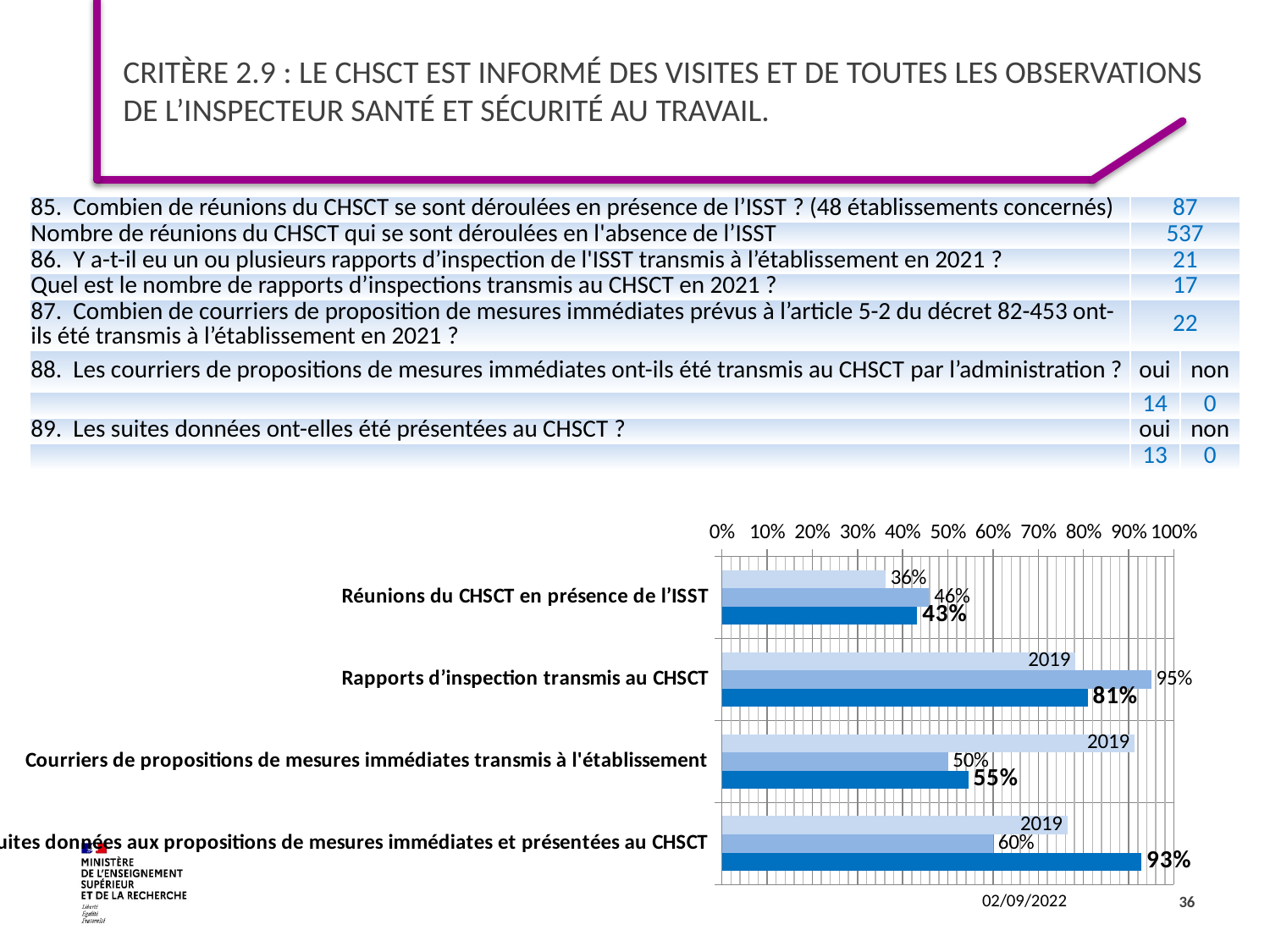
In the bar chart, what value is shown on the lightest (top) bar for 'Réunions du CHSCT en présence de l'ISST'? 36% How many bars are shown for each category in the bar chart? 3 In the bar chart, what value is shown on the darkest (bottom) bar for 'Rapports d'inspection transmis au CHSCT'? 81% In the bar chart, is the lightest (2019) bar for 'Courriers de propositions de mesures immédiates transmis à l'établissement' greater or less than 80%? greater In the bar chart, what value is shown on the middle bar for 'Rapports d'inspection transmis au CHSCT'? 95% How many categories are plotted in the bar chart? 4 What type of chart is shown at the bottom of the slide? bar chart In the bar chart, what value is shown on the darkest (bottom) bar for 'Courriers de propositions de mesures immédiates transmis à l'établissement'? 55% In the bar chart, what value is shown on the darkest (bottom) bar of the last (bottom) category? 93% In the bar chart, for 'Courriers de propositions de mesures immédiates transmis à l'établissement', which is larger: the middle bar or the darkest bar? the darkest bar (55%) In the bar chart, what value is shown on the darkest (bottom) bar for 'Réunions du CHSCT en présence de l'ISST'? 43% In the bar chart, what is the difference between the middle bar and the darkest bar for 'Rapports d'inspection transmis au CHSCT'? 14 percentage points